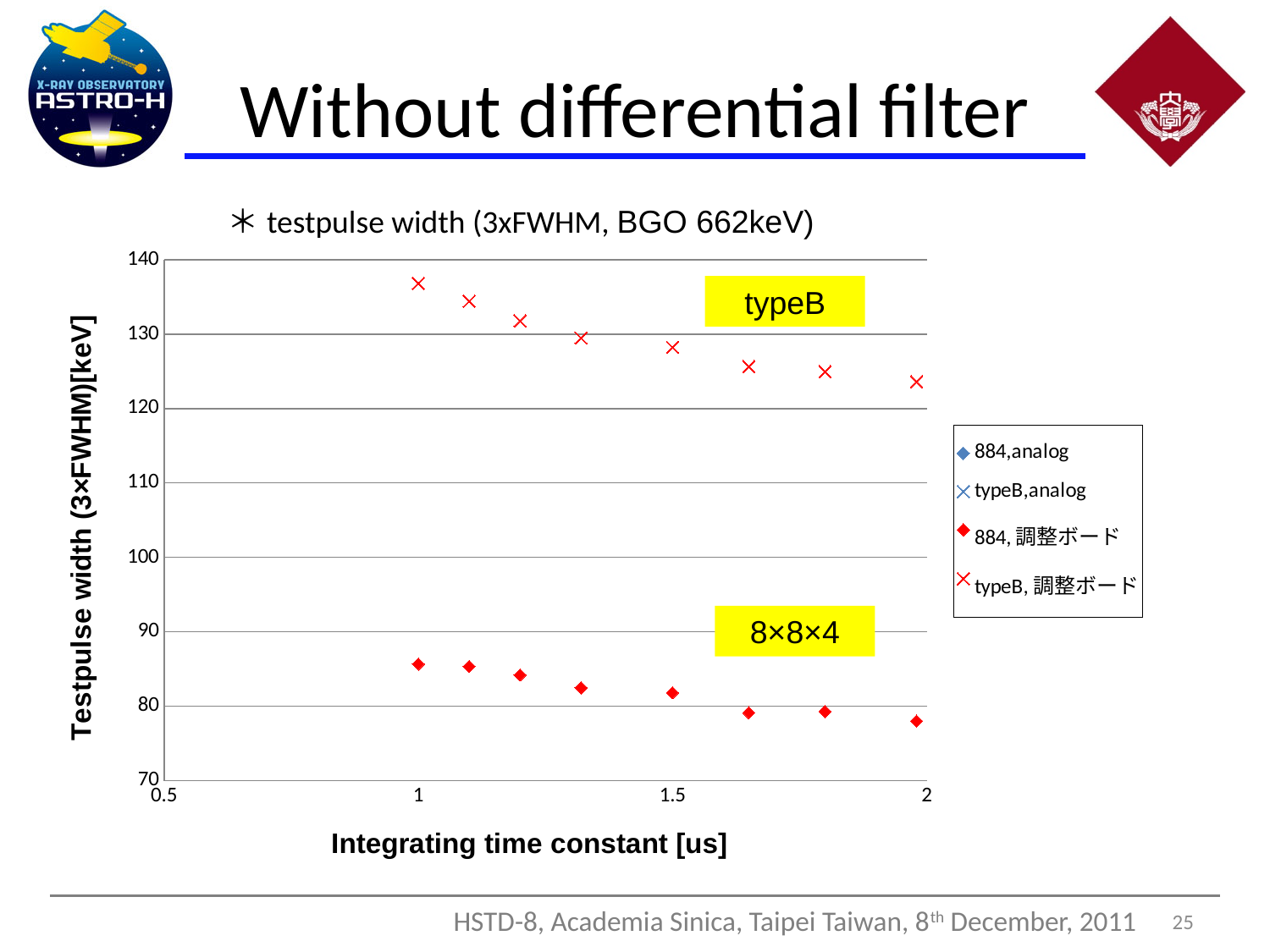
What is the label of the x axis? Integrating time constant [us] What is the label of the y axis? Testpulse width (3×FWHM)[keV] Do the typeB values rise or fall as the integrating time constant increases? fall Do the 8×8×4 values rise or fall as the integrating time constant increases? fall Is the typeB testpulse width at an integrating time constant of 1 us greater or less than 130? greater Which has the larger testpulse width at an integrating time constant of 1.5 us, typeB or 8×8×4? typeB Is the typeB testpulse width at an integrating time constant of 2 us greater or less than 120? greater Is the 8×8×4 testpulse width at an integrating time constant of 2 us greater or less than 80? less What kind of chart is shown on the slide? scatter chart How many data points are plotted for the typeB series? 8 How many series does the legend list? 4